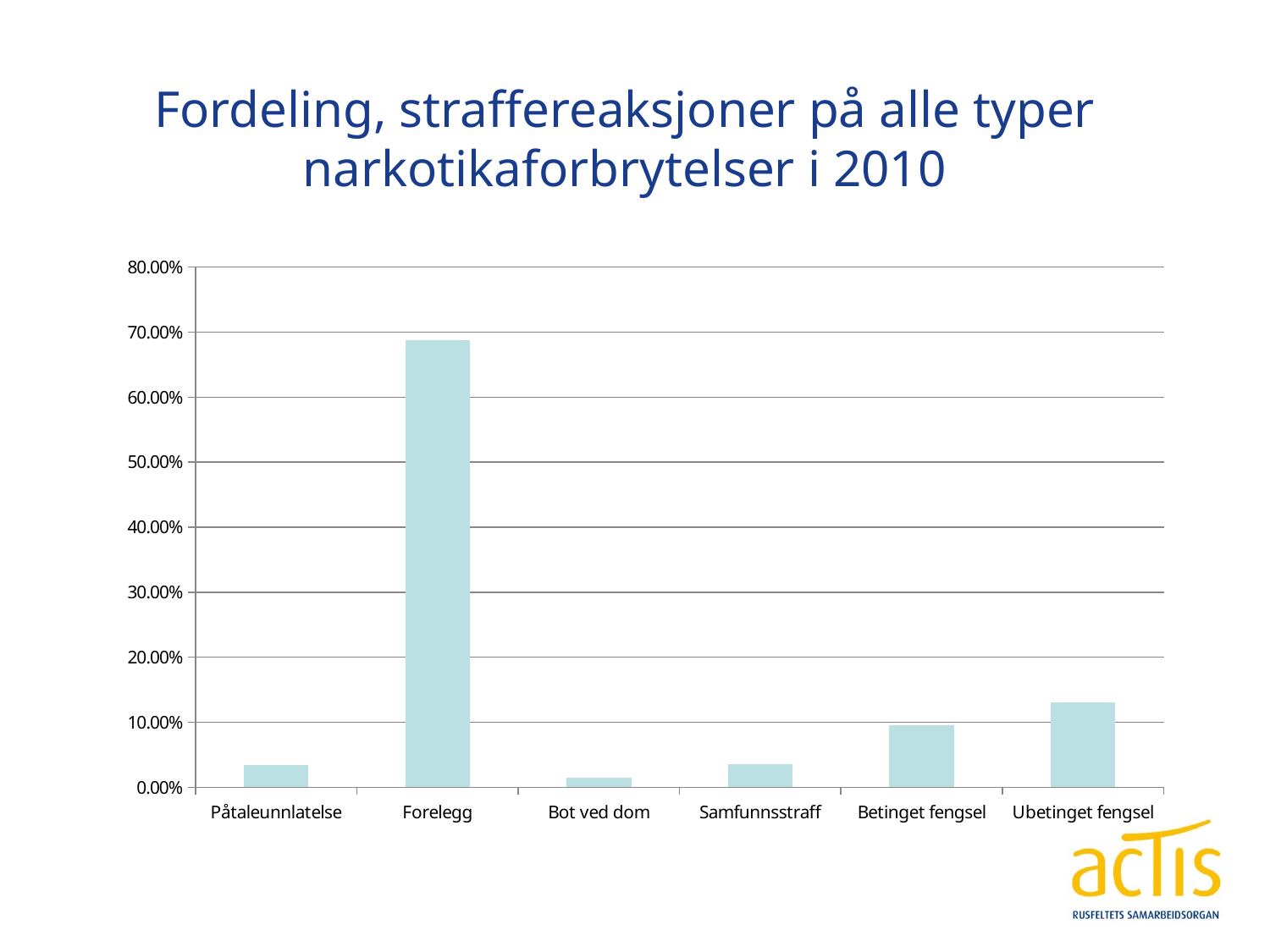
Is the value for Forelegg greater or less than 60.00%? greater Which is larger, the value for Samfunnsstraff or the value for Bot ved dom? Samfunnsstraff Which category has the lowest value? Bot ved dom Is the value for Påtaleunnlatelse greater or less than 10.00%? less What is the title of the chart? Fordeling, straffereaksjoner på alle typer narkotikaforbrytelser i 2010 How many categories are shown on the x axis? 6 Is the value for Forelegg greater or less than 70.00%? less Which category has the highest value? Forelegg What kind of chart is shown on the slide? Bar chart Which is larger, the value for Ubetinget fengsel or the value for Betinget fengsel? Ubetinget fengsel